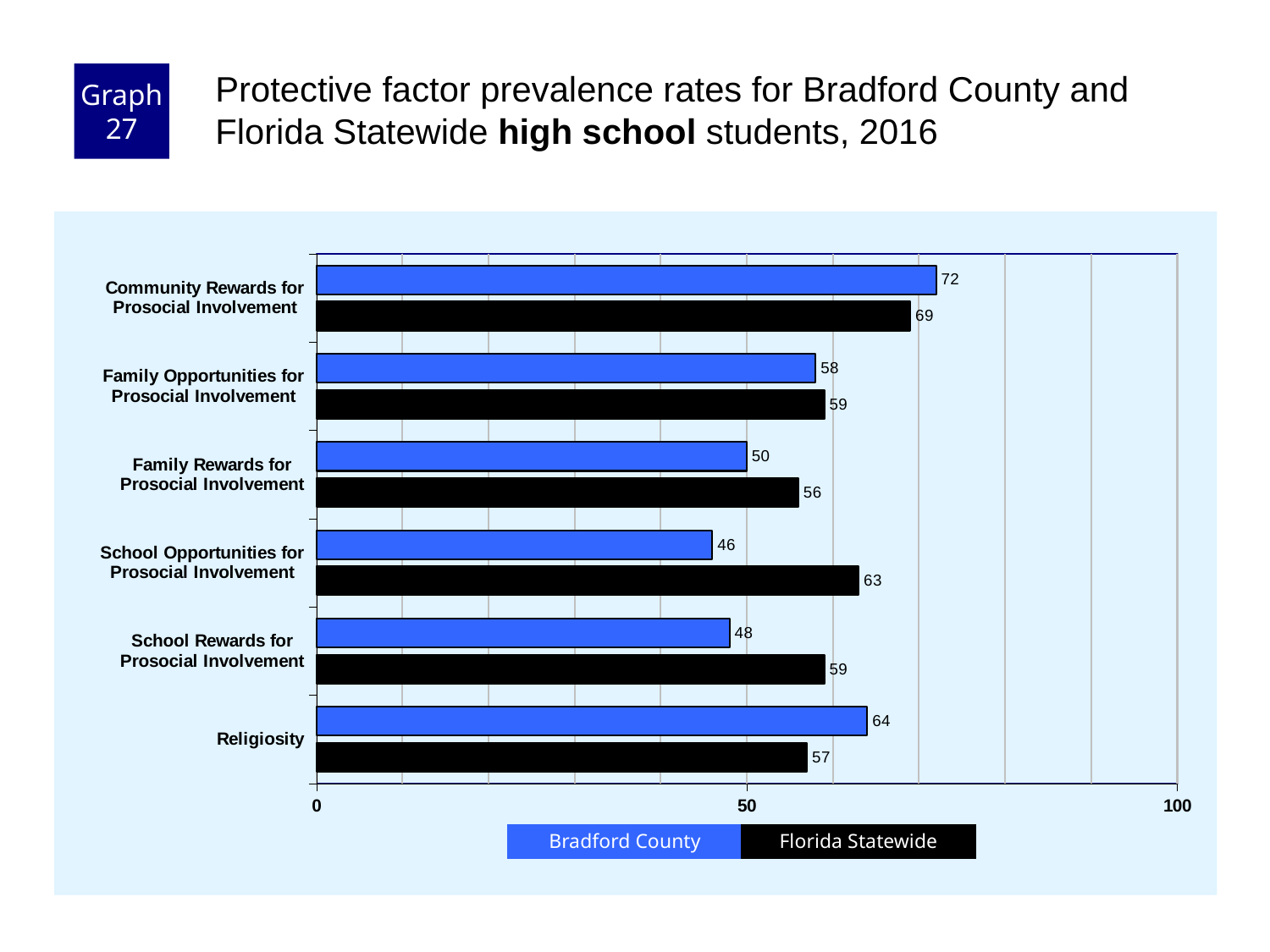
Is the Bradford County value for Family Rewards for Prosocial Involvement greater or less than 50? It equals 50 Which category has the lowest Bradford County value? School Opportunities for Prosocial Involvement What is the Bradford County value for Religiosity? 64 Which category has the highest Bradford County value? Community Rewards for Prosocial Involvement What is the difference between the Florida Statewide and Bradford County values for School Opportunities for Prosocial Involvement? 17 How many series does the legend list? 2 How many categories are shown on the chart? 6 Which is larger for Religiosity, the Bradford County value or the Florida Statewide value? Bradford County What kind of chart is shown on the slide? Bar chart What is the Florida Statewide value for School Opportunities for Prosocial Involvement? 63 Which colour represents Florida Statewide in the chart? Black What is the Bradford County value for Community Rewards for Prosocial Involvement? 72